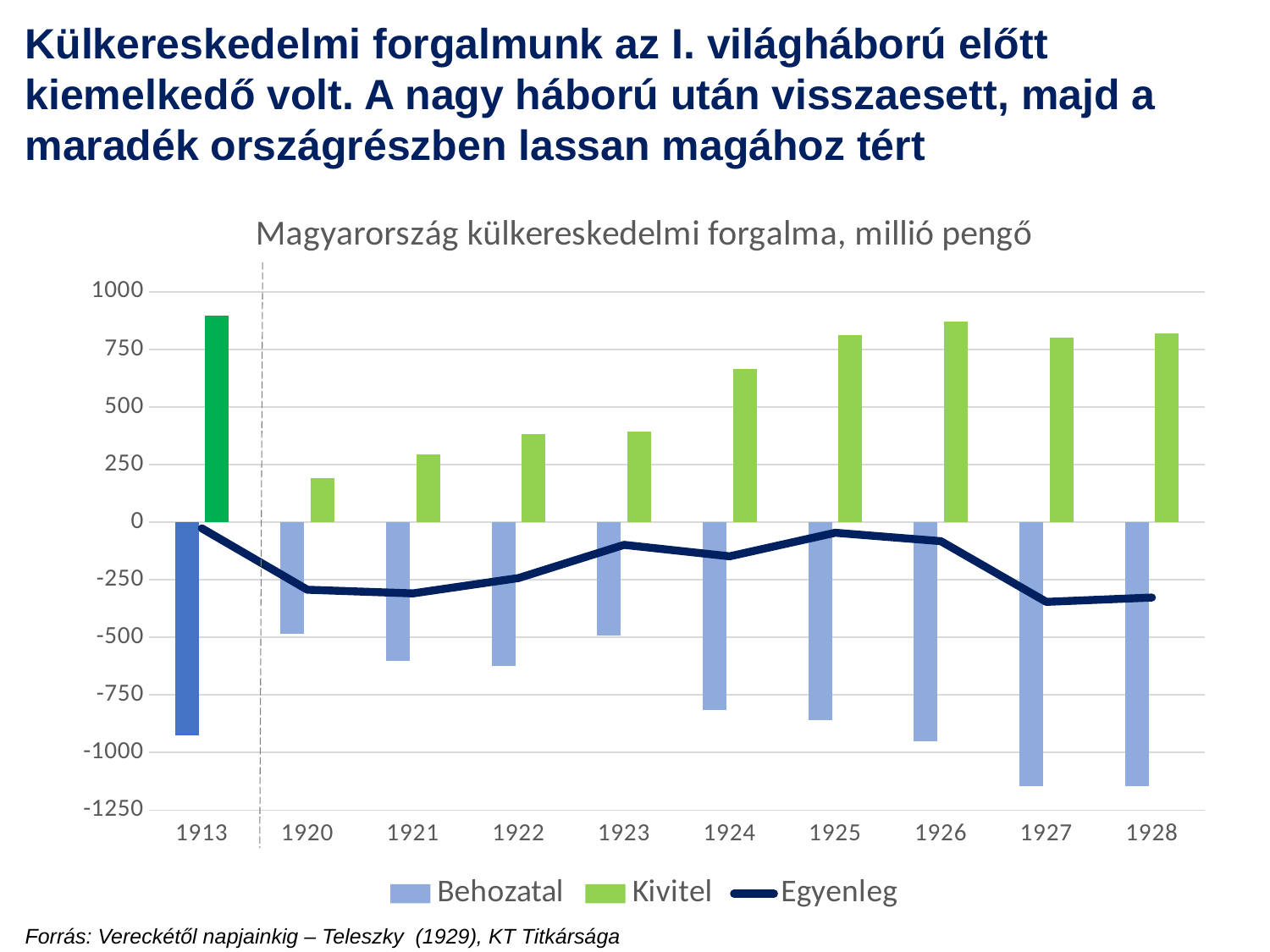
Is the Kivitel value for 1920 greater or less than 250? less Is the Kivitel value for 1924 greater or less than 500? greater Is the Behozatal value for 1927 greater or less than -1000? less How many series does the legend list? 3 Does the Kivitel value rise or fall from 1920 to 1926? rise What is the title of the chart? Magyarország külkereskedelmi forgalma, millió pengő Which year has the larger Kivitel value, 1923 or 1925? 1925 Which year has the highest Kivitel value? 1913 How many years are shown on the x axis? 10 Which year has the lowest Kivitel value? 1920 What kind of chart is shown on the slide? bar chart with a line